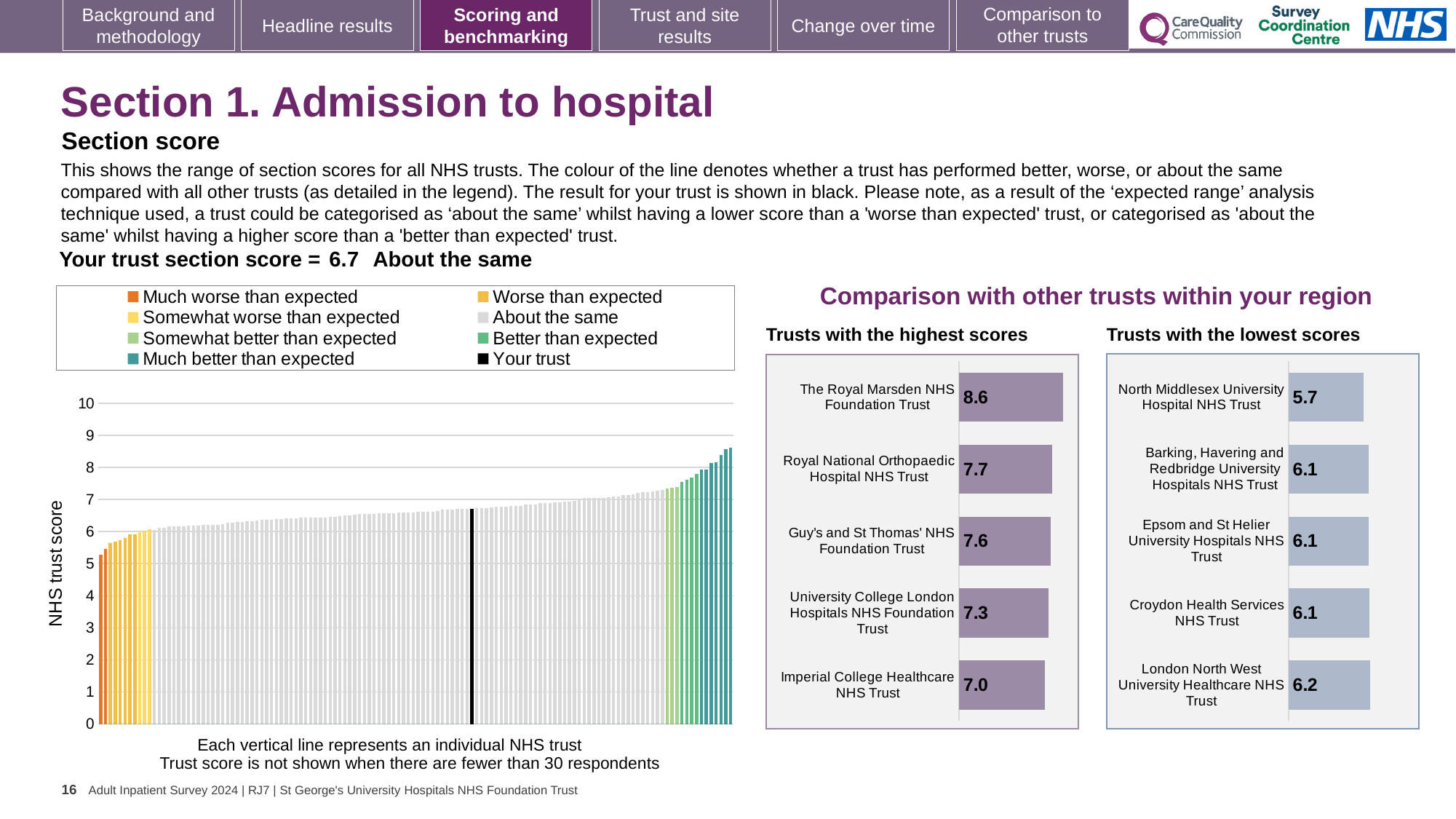
In the main NHS trust score chart on the left, do the bar values rise or fall from left to right? rise In the main NHS trust score chart on the left, what is the section score for your trust (the black bar)? 6.7 In the 'Trusts with the highest scores' chart, which has the higher score: Royal National Orthopaedic Hospital NHS Trust or Guy's and St Thomas' NHS Foundation Trust? Royal National Orthopaedic Hospital NHS Trust In the 'Trusts with the lowest scores' chart, what is the difference between the scores of London North West University Healthcare NHS Trust and North Middlesex University Hospital NHS Trust? 0.5 How many entries does the legend of the main NHS trust score chart list? 8 In the main NHS trust score chart on the left, is the value of the leftmost bar greater or less than 6? less How many trusts are shown in the 'Trusts with the lowest scores' chart? 5 In the 'Trusts with the highest scores' chart, what is the score for The Royal Marsden NHS Foundation Trust? 8.6 In the 'Trusts with the lowest scores' chart, which trust has the highest score shown? London North West University Healthcare NHS Trust In the 'Trusts with the lowest scores' chart, what is the score for North Middlesex University Hospital NHS Trust? 5.7 In the 'Trusts with the highest scores' chart, what is the difference between the scores of The Royal Marsden NHS Foundation Trust and Imperial College Healthcare NHS Trust? 1.6 In the 'Trusts with the highest scores' chart, which trust has the lowest score shown? Imperial College Healthcare NHS Trust